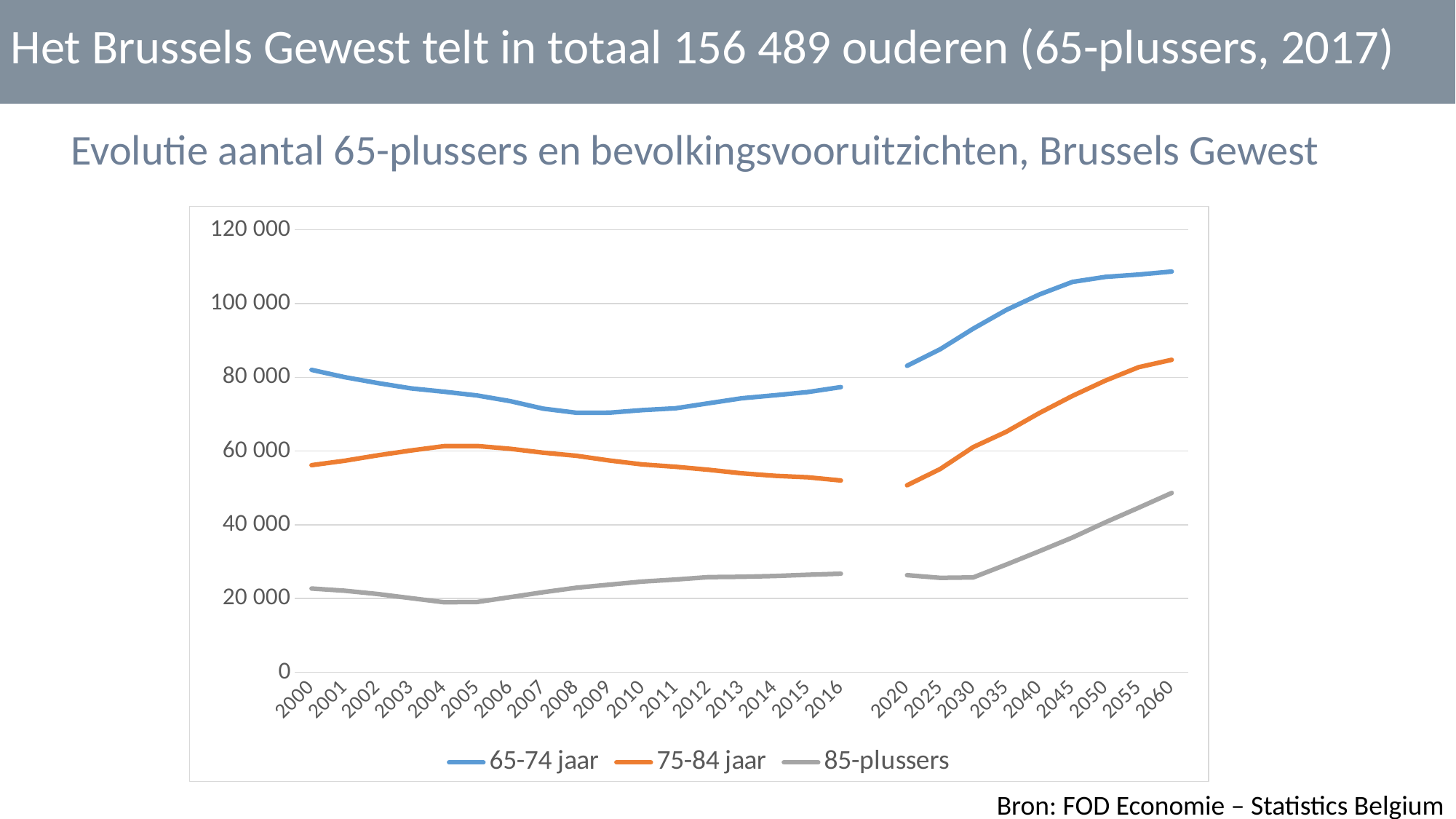
Which series has the highest value in 2060? 65-74 jaar How many series does the legend list? 3 What kind of chart is shown on the slide? line chart Which series has the lowest value in 2000? 85-plussers Does the 65-74 jaar line rise or fall from 2020 to 2060? rise Is the value for 85-plussers in 2060 greater or less than 40 000? greater Which is larger in 2000: the value for 65-74 jaar or the value for 75-84 jaar? 65-74 jaar Is the value for 65-74 jaar in 2060 greater or less than 100 000? greater How many years are shown on the x axis? 26 Is the value for 75-84 jaar in 2016 greater or less than 60 000? less